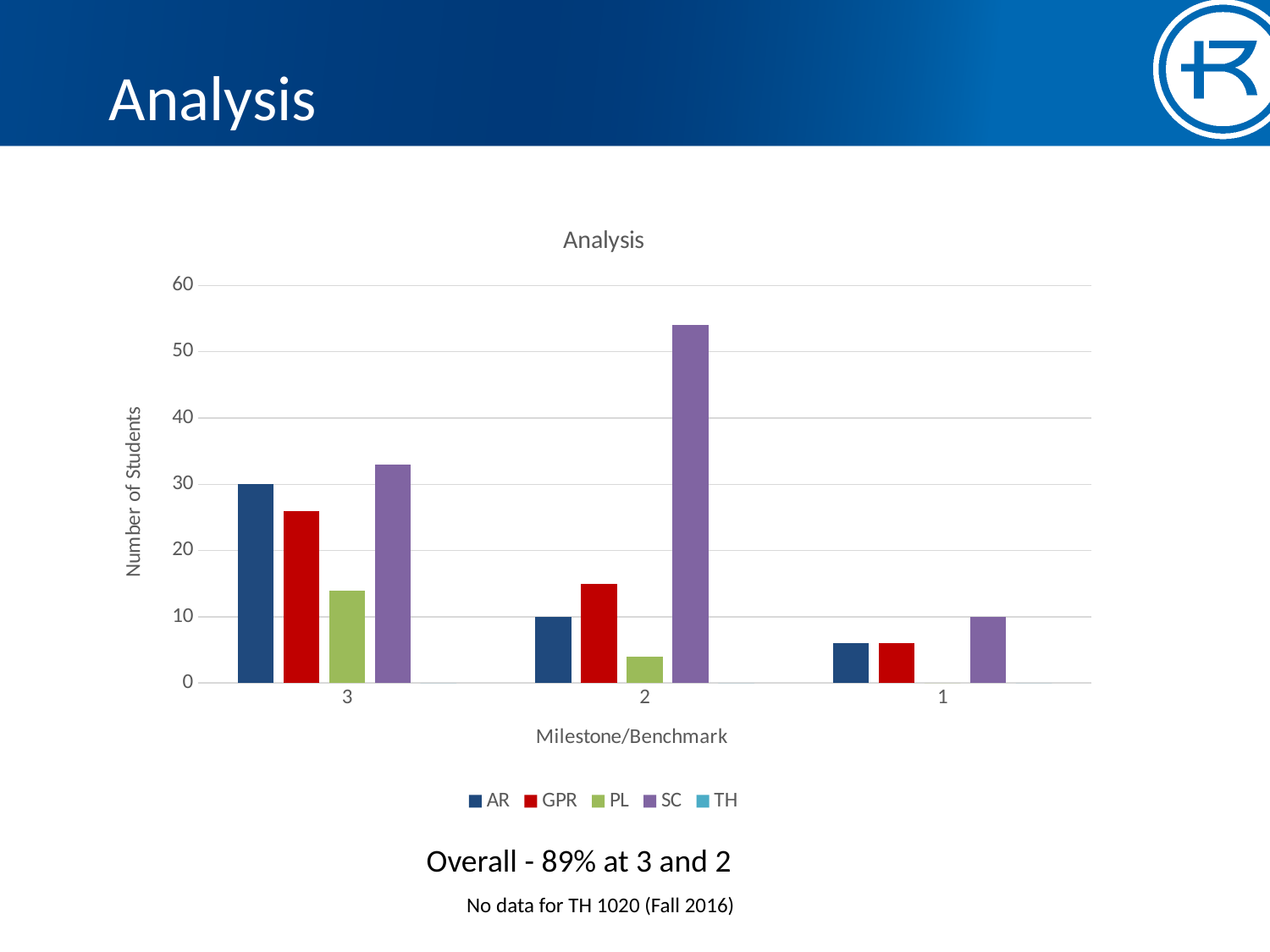
What is the number of students for AR at milestone 2? 10 How many milestone/benchmark categories are shown on the x axis? 3 Do the AR values rise or fall going from milestone 3 to milestone 1? fall How many series does the legend list? 5 What kind of chart is shown on the slide? bar chart What is the number of students for AR at milestone 3? 30 Is the value for PL at milestone 2 greater or less than 10? less Which series has the shortest bar at milestone 3? PL Which series has the tallest bar at milestone 2? SC Which is larger at milestone 3, GPR or PL? GPR Is the value for SC at milestone 2 greater or less than 50? greater What is the number of students for SC at milestone 1? 10